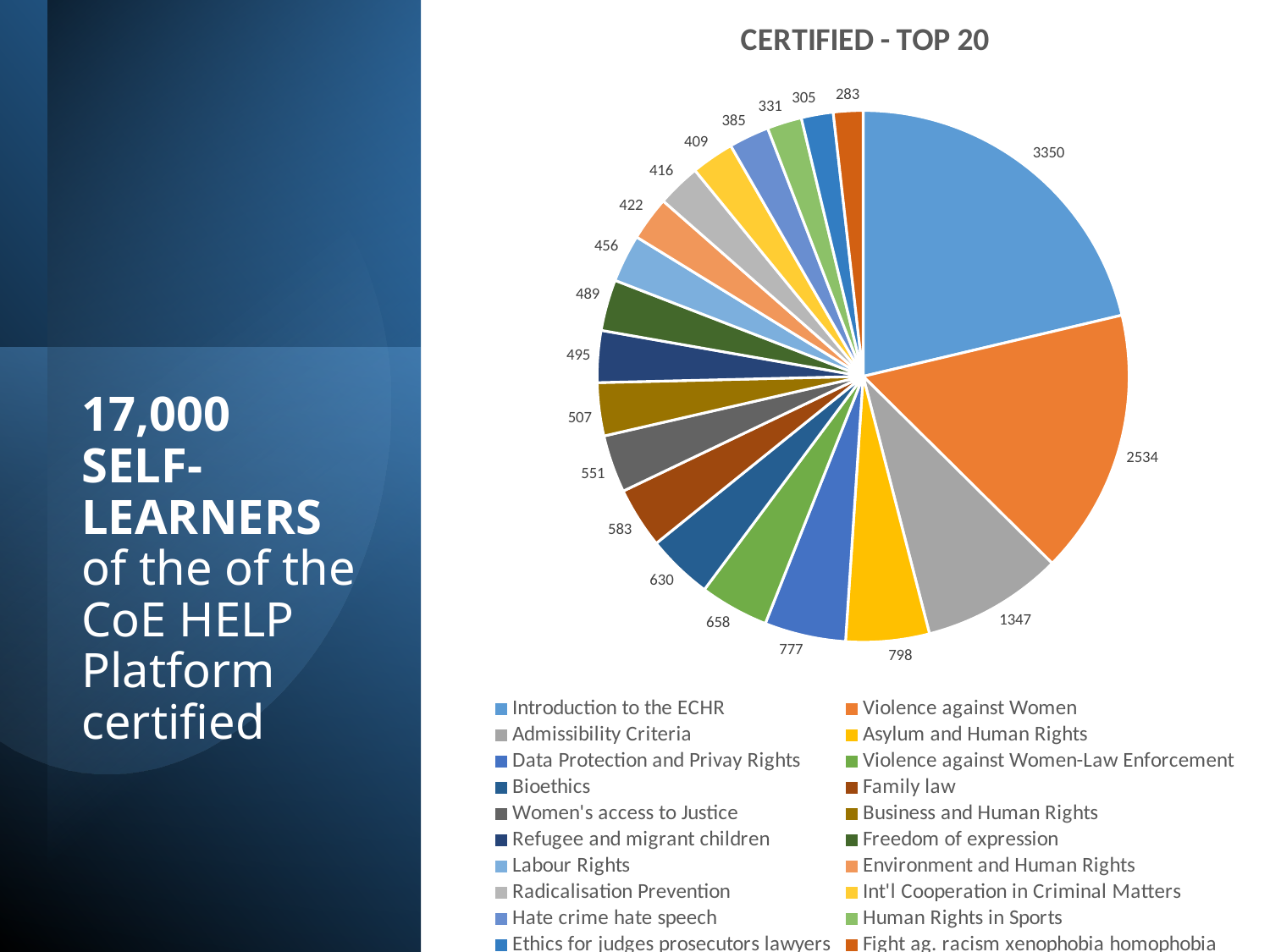
What is the value for Introduction to the ECHR? 3350 How many slices does the pie chart have? 20 What is the value for Bioethics? 630 Which category has the smallest slice? Fight ag. racism xenophobia homophobia What is the difference between the values for Labour Rights and Human Rights in Sports? 125 What is the difference between the values for Introduction to the ECHR and Violence against Women? 816 What is the title of the chart? CERTIFIED - TOP 20 What kind of chart is shown on the slide? pie chart What is the value for Admissibility Criteria? 1347 Which is larger, the value for Asylum and Human Rights or the value for Family law? Asylum and Human Rights What is the value for Violence against Women? 2534 Which category has the largest slice? Introduction to the ECHR